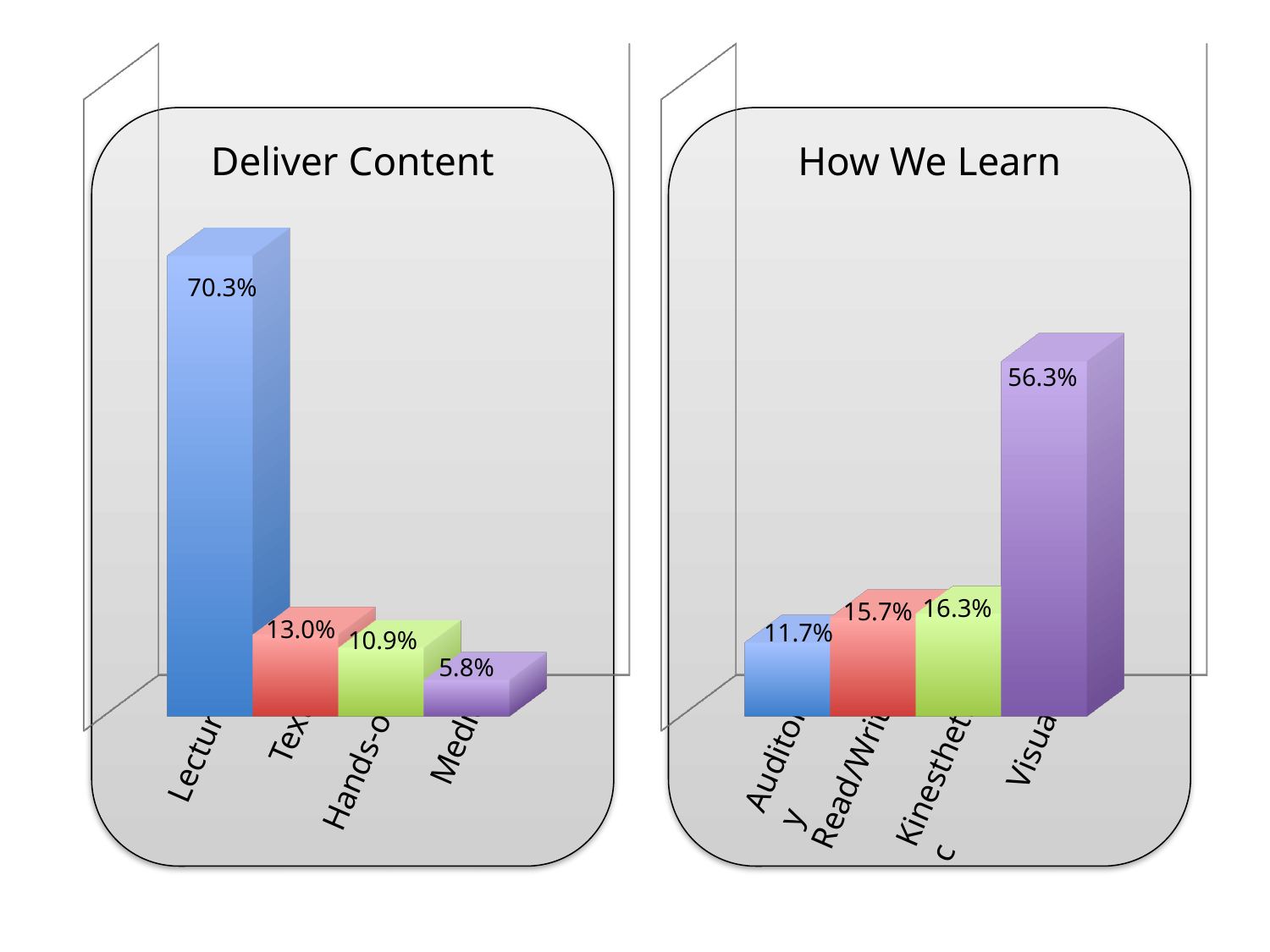
In the How We Learn chart, which category has the highest value? Visual In the Deliver Content chart, which category has the lowest value? Media In the How We Learn chart, what is the value for Visual? 56.3% In the Deliver Content chart, what is the value for Media? 5.8% In the How We Learn chart, what is the difference between Visual and Kinesthetic? 40.0% In the How We Learn chart, which is larger, Read/Write or Kinesthetic? Kinesthetic In the Deliver Content chart, what is the difference between Lecture and Text? 57.3% In the Deliver Content chart, what is the value for Lecture? 70.3% What kind of chart is the How We Learn chart? Bar chart In the Deliver Content chart, how many categories are shown? 4 What is the title of the chart on the left side of the slide? Deliver Content In the How We Learn chart, what is the value for Auditory? 11.7%